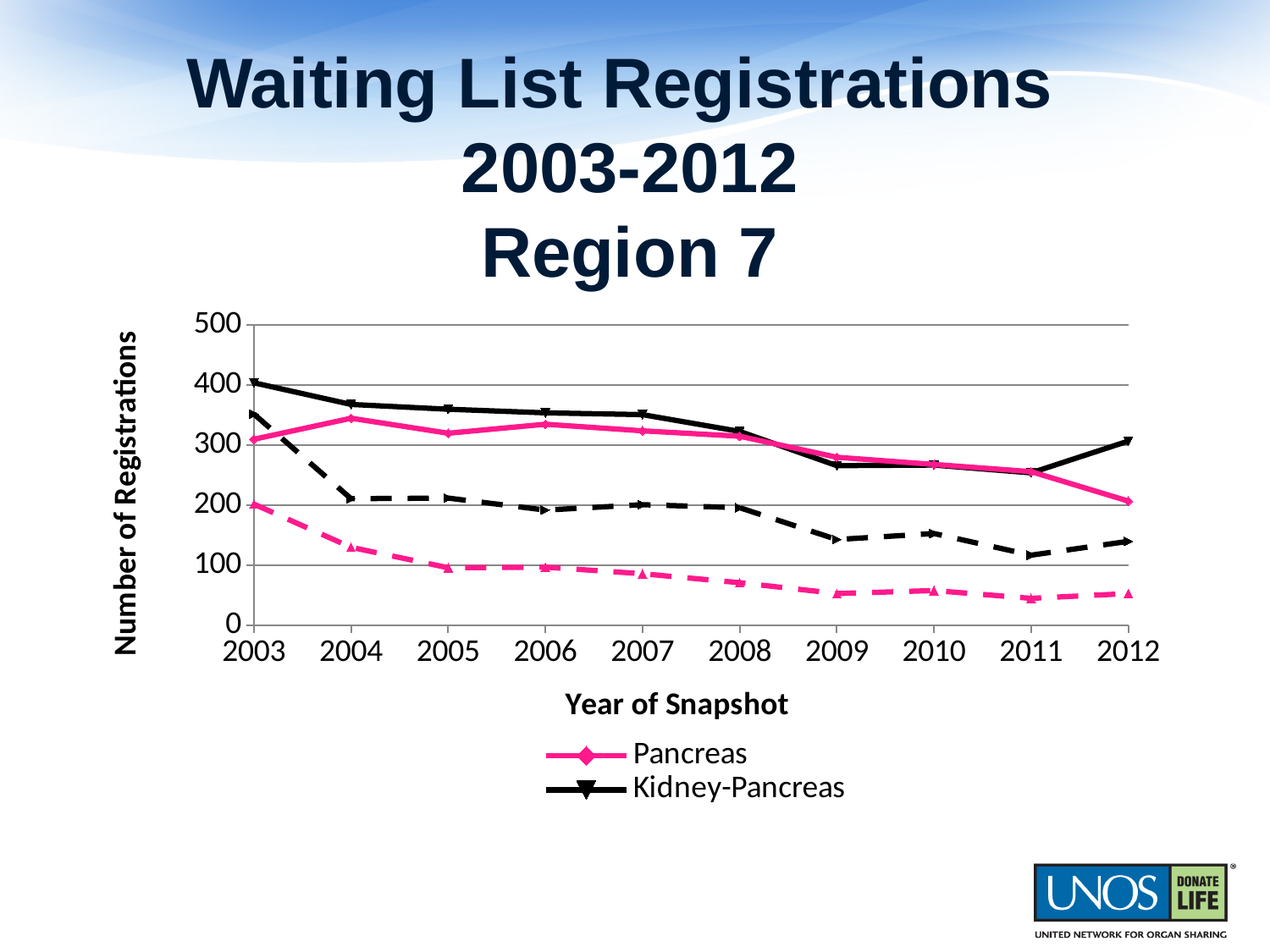
In which year is the Pancreas series at its lowest? 2012 Is the value for Pancreas in 2004 greater or less than 300? greater What is the title of the y axis? Number of Registrations How many series does the legend list? 2 In 2003, which series has the larger value, Pancreas or Kidney-Pancreas? Kidney-Pancreas Is the value for Pancreas in 2012 greater or less than 300? less In which year is the Kidney-Pancreas series at its highest? 2003 What kind of chart is shown on the slide? Line chart Is the value for Kidney-Pancreas in 2003 greater or less than 300? greater Does the Pancreas series generally rise or fall from 2003 to 2012? Fall How many years are shown along the x axis? 10